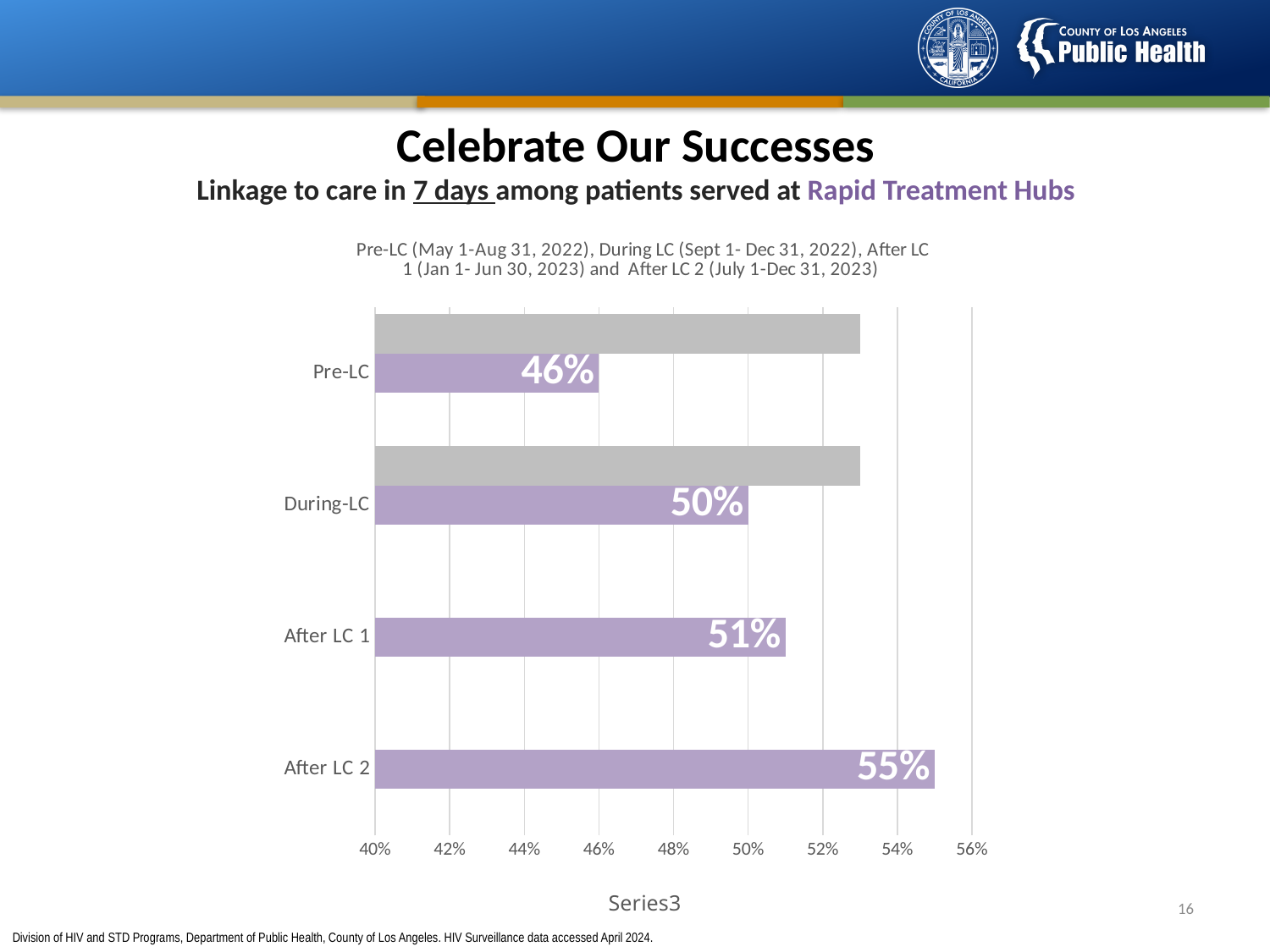
Which category has the highest labelled purple bar value? After LC 2 What is the difference between the labelled values for After LC 2 and Pre-LC? 9% Is the value of the gray bar for Pre-LC greater or less than 52%? greater What is the value of the purple bar for During-LC? 50% Which category has the lowest labelled purple bar value? Pre-LC What is the value of the purple bar for After LC 2? 55% What kind of chart is shown on the slide? Bar chart Which is larger, the labelled value for During-LC or for After LC 1? After LC 1 What is the value of the purple bar for After LC 1? 51% What is the value of the purple bar for Pre-LC? 46% How many categories are shown on the vertical axis of the chart? 4 Do the labelled purple bar values rise or fall from Pre-LC to After LC 2? Rise